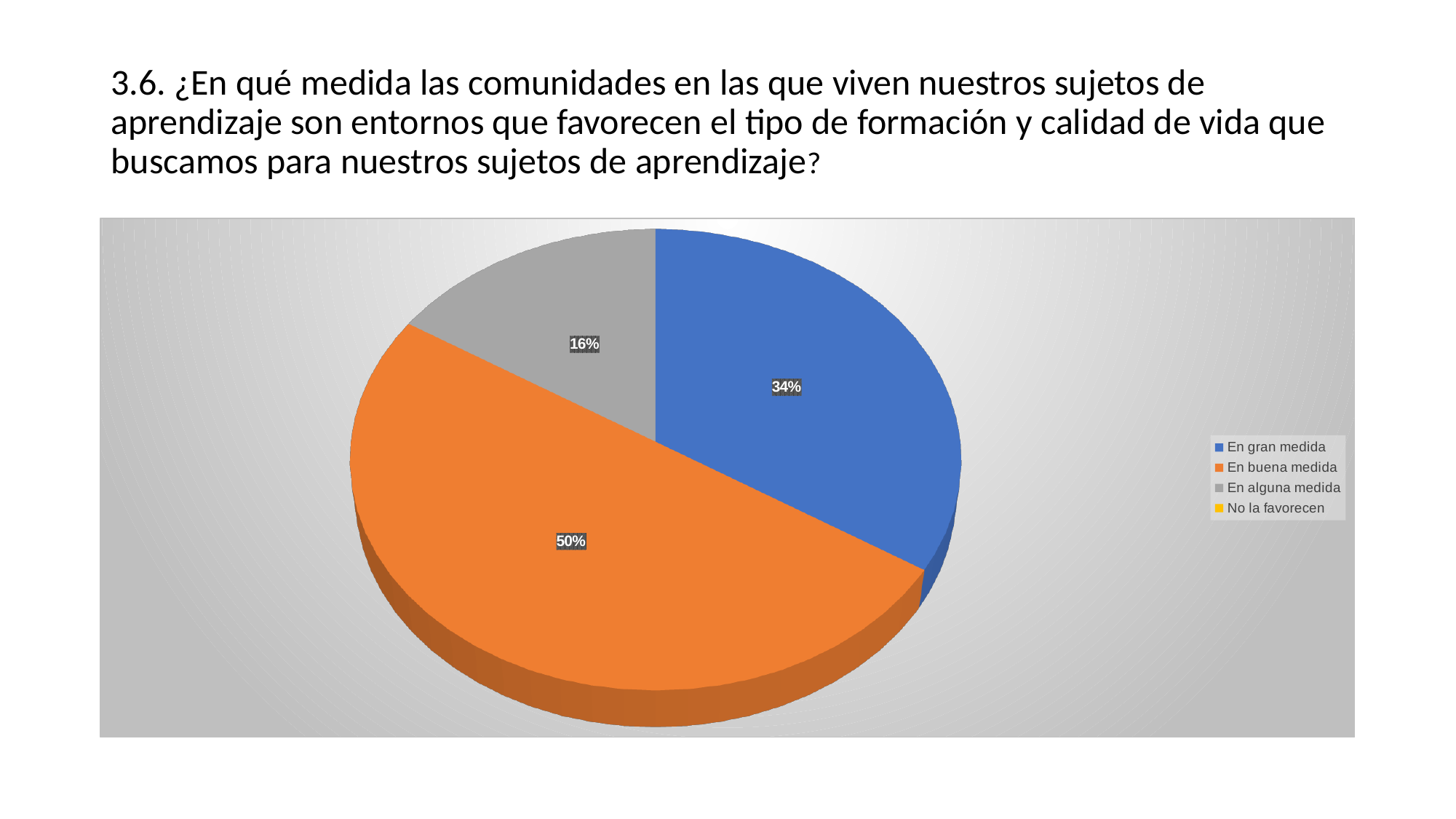
Which is larger, the share for "En gran medida" or the share for "En alguna medida"? En gran medida Which category with a visible slice has the smallest share of the pie? En alguna medida What is the difference in percentage points between "En gran medida" and "En alguna medida"? 18 What share of the pie does "En gran medida" represent? 34% Which legend entry is shown in yellow? No la favorecen What kind of chart is shown on the slide? pie chart What is the difference in percentage points between "En buena medida" and "En gran medida"? 16 What share of the pie does "En alguna medida" represent? 16% What share of the pie does "En buena medida" represent? 50% What colour is the slice for "En buena medida"? orange Which category has the largest slice of the pie? En buena medida How many categories does the legend list? 4